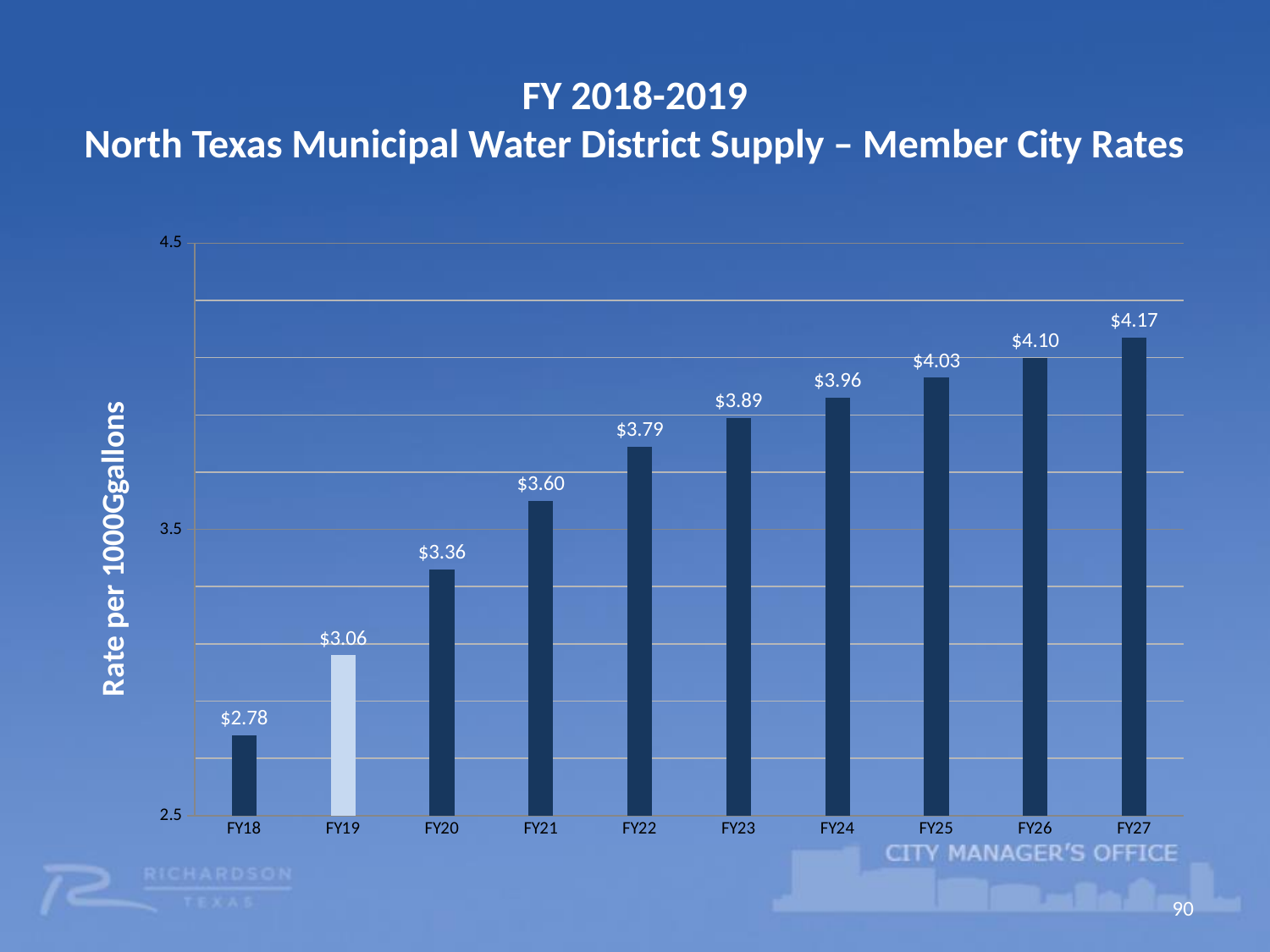
What is the rate per 1000 gallons for FY27? $4.17 Do the rates rise or fall from FY18 to FY27? rise What is the difference between the FY27 rate and the FY18 rate? $1.39 What kind of chart is shown on the slide? bar chart Which fiscal year has the lowest rate? FY18 Which is larger, the rate for FY22 or the rate for FY24? FY24 How many fiscal years are shown on the x axis? 10 Which fiscal year has the highest rate? FY27 What is the rate per 1000 gallons for FY19? $3.06 What is the rate per 1000 gallons for FY23? $3.89 What is the difference between the FY20 rate and the FY19 rate? $0.30 Is the rate for FY21 greater or less than 3.5? greater